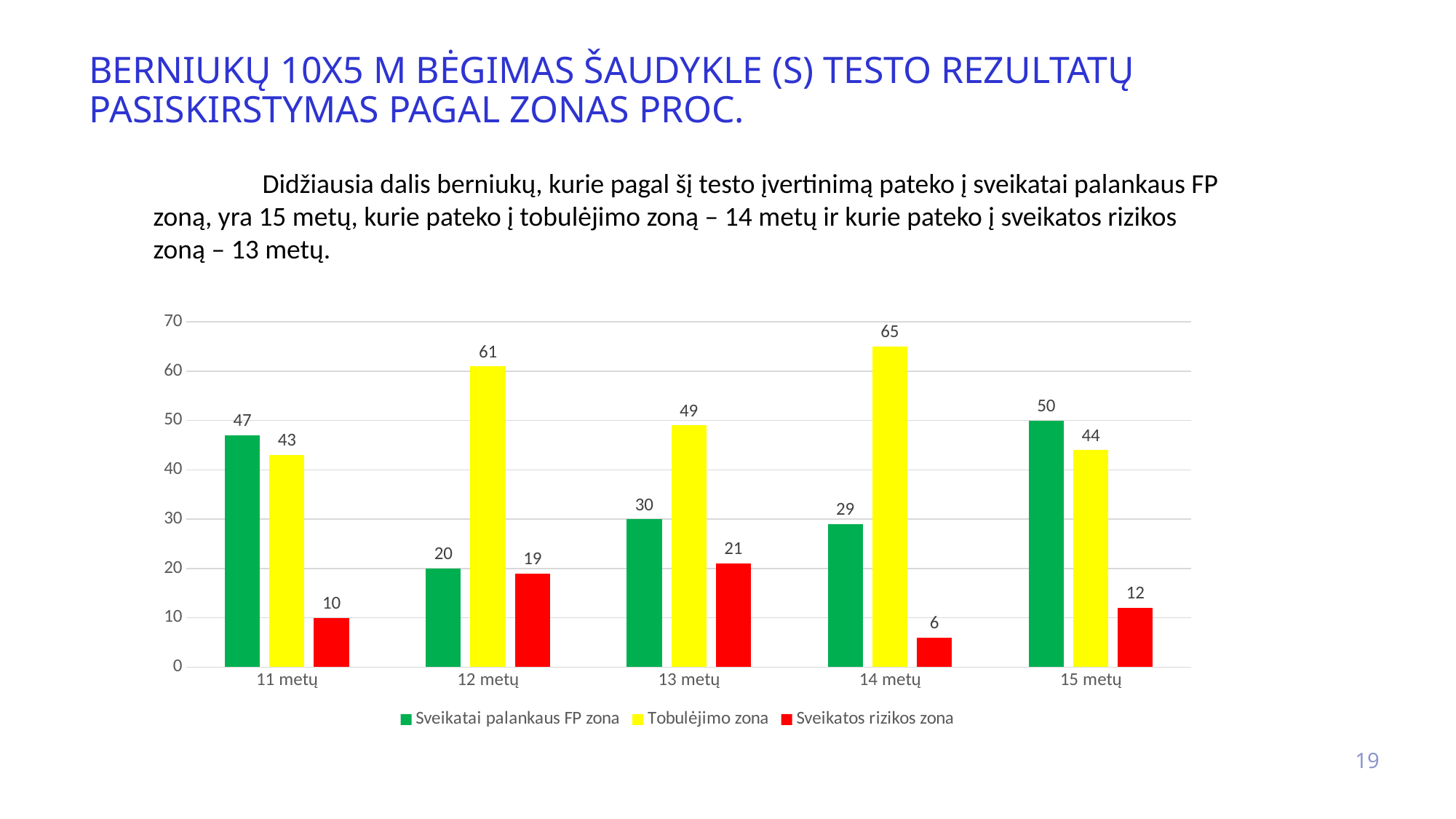
How many series does the legend list? 3 What colour represents Sveikatos rizikos zona in the legend? Red What is the value of Sveikatai palankaus FP zona for 11 metų? 47 What is the difference between the Tobulėjimo zona value and the Sveikatai palankaus FP zona value for 12 metų? 41 What is the value of Sveikatos rizikos zona for 13 metų? 21 What kind of chart is shown on the slide? Bar chart What is the value of Tobulėjimo zona for 14 metų? 65 Which age group has the lowest value for Sveikatos rizikos zona? 14 metų How many age groups are shown on the x axis? 5 Which age group has the highest value for Sveikatai palankaus FP zona? 15 metų Which is larger for 15 metų: Sveikatai palankaus FP zona or Tobulėjimo zona? Sveikatai palankaus FP zona Which age group has the highest value for Tobulėjimo zona? 14 metų